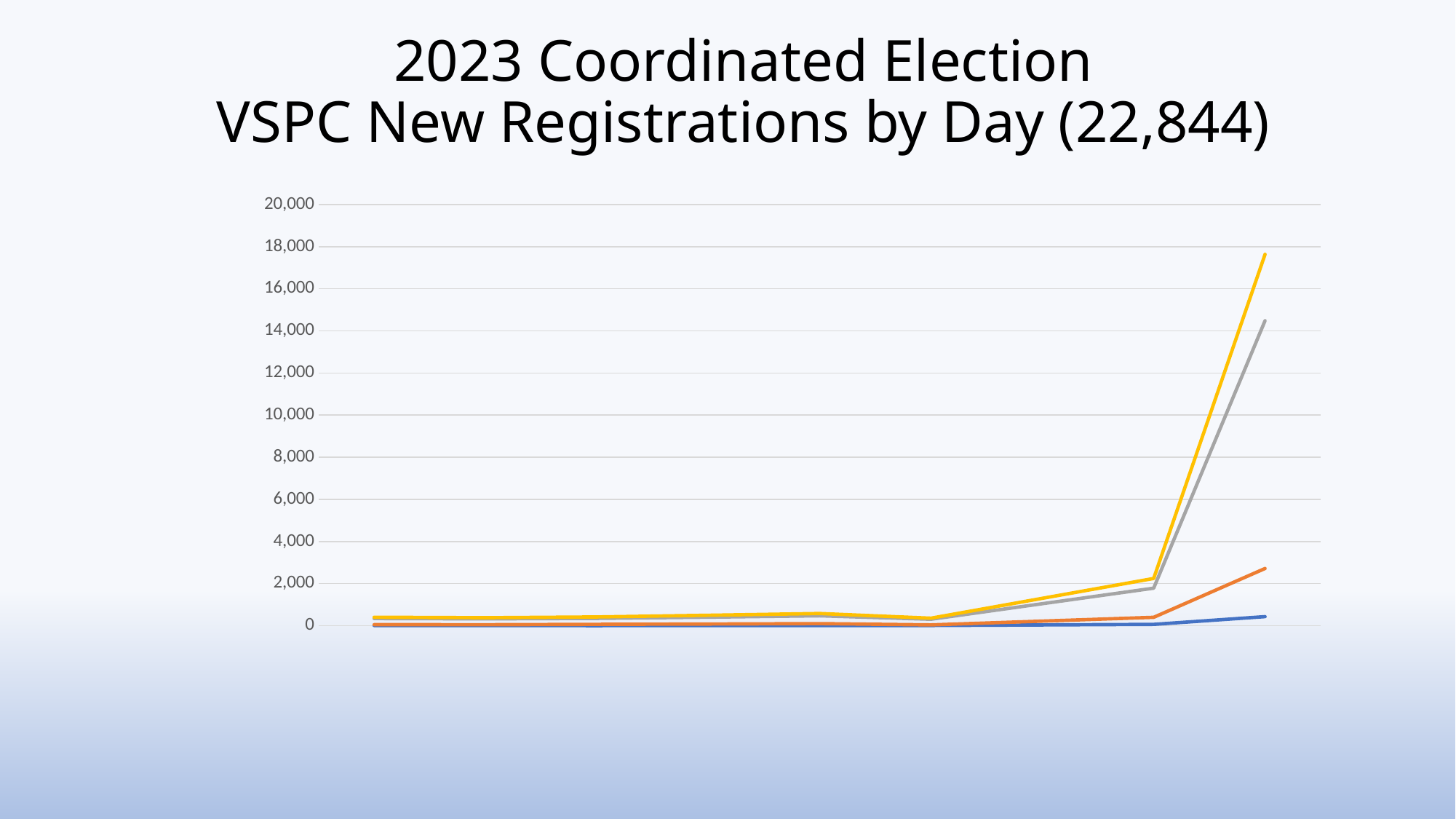
How many lines are plotted on the chart? 4 At the right end of the chart, is the blue line's value greater or less than 2,000? less Do the yellow and gray lines rise or fall toward the right end of the chart? rise Which coloured line reaches the highest value on the chart? yellow At the right end of the chart, which is higher: the yellow line or the gray line? yellow line What kind of chart is shown on the slide? line chart At the right end of the chart, is the yellow line's value greater or less than 16,000? greater At the right end of the chart, is the gray line's value greater or less than 12,000? greater What is the title of the chart on the slide? 2023 Coordinated Election VSPC New Registrations by Day (22,844) What total number of registrations is given in parentheses in the chart title? 22,844 Which coloured line has the lowest value at the right end of the chart? blue